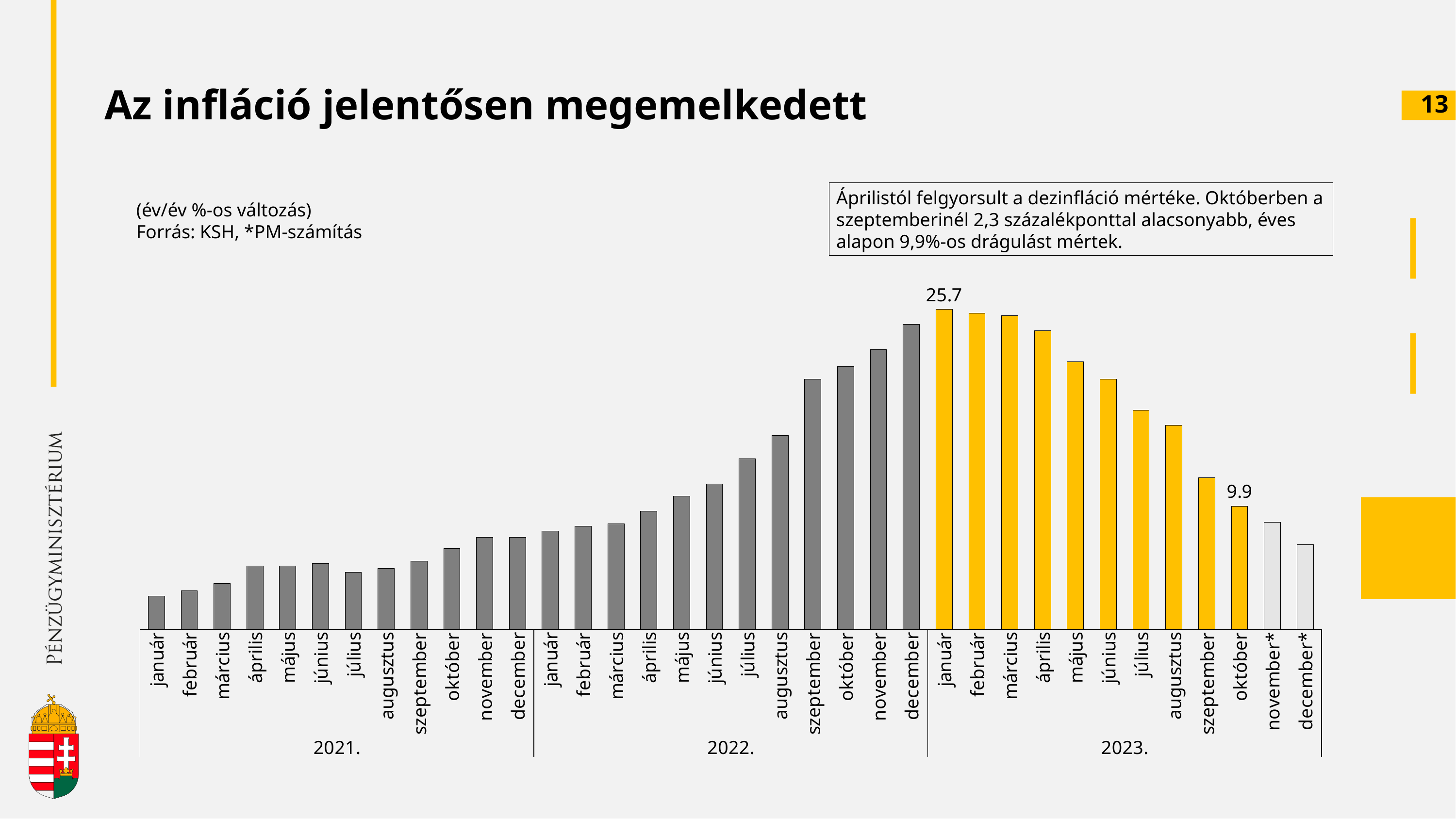
What kind of chart is shown on the slide? bar chart Which month has the lowest bar in the chart? január 2021 What is the value shown for január 2023? 25.7 What is the difference between the values for január 2023 and október 2023? 15.8 Which month has the highest bar in the chart? január 2023 Which is larger, the value for december 2022 or the value for december 2021? december 2022 How many years are shown along the x axis? 3 Do the values rise or fall across the months of 2022? rise What is the value shown for október 2023? 9.9 What is the title of the slide? Az infláció jelentősen megemelkedett Do the values rise or fall across the months of 2023? fall How many monthly bars are plotted in the chart? 36